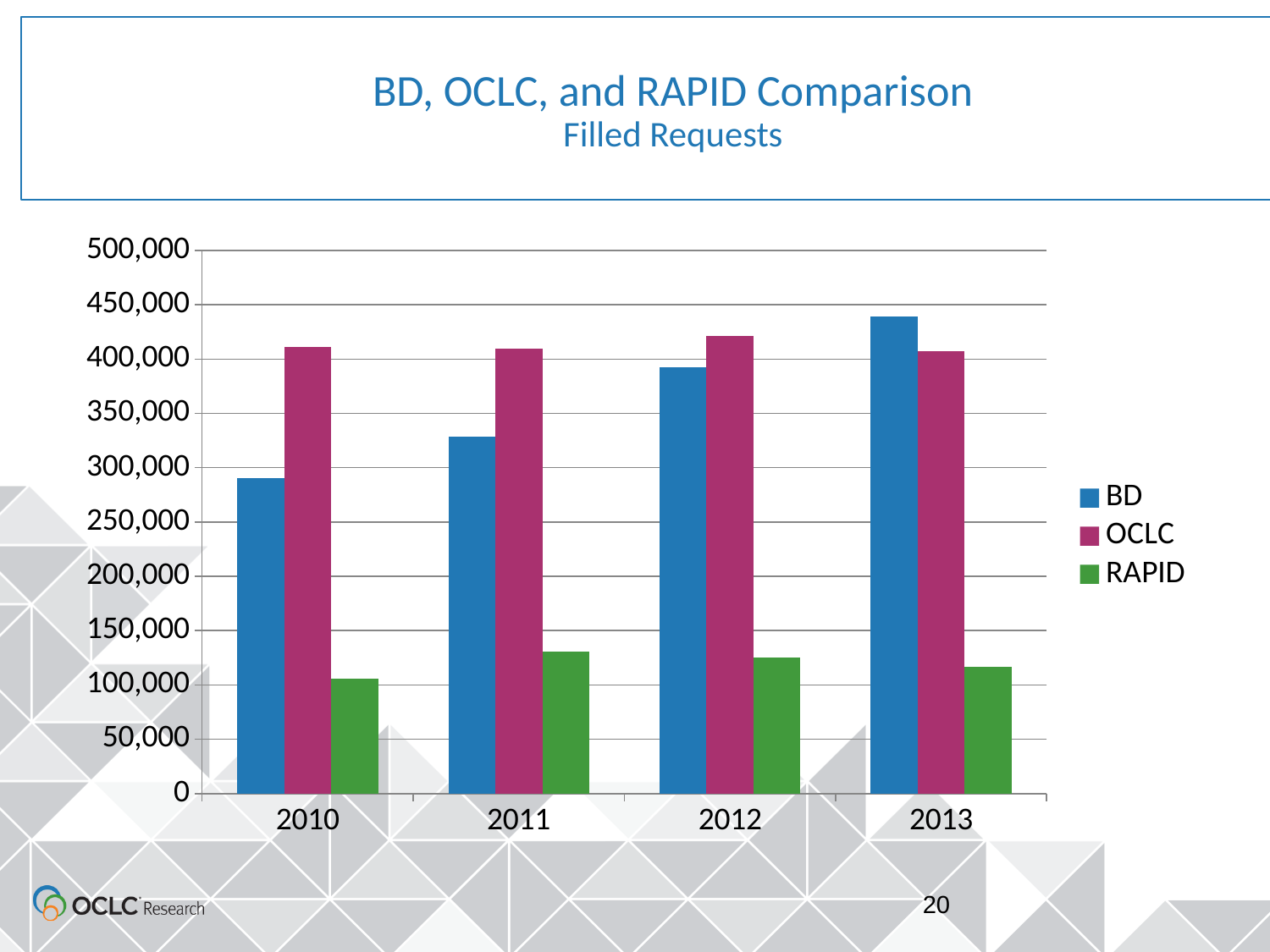
What is the title of the chart on the slide? BD, OCLC, and RAPID Comparison Filled Requests Is the value for RAPID in 2011 greater or less than 100,000? greater In 2010, which is larger, BD or OCLC? OCLC What kind of chart is shown on the slide? bar chart Is the value for OCLC in 2012 greater or less than 400,000? greater In which year is the RAPID value lowest? 2010 How many years are shown on the x axis? 4 Is the value for BD in 2010 greater or less than 300,000? less How many series does the legend list? 3 In which year is the BD value highest? 2013 Do the BD values rise or fall from 2010 to 2013? rise In 2013, which is larger, BD or OCLC? BD